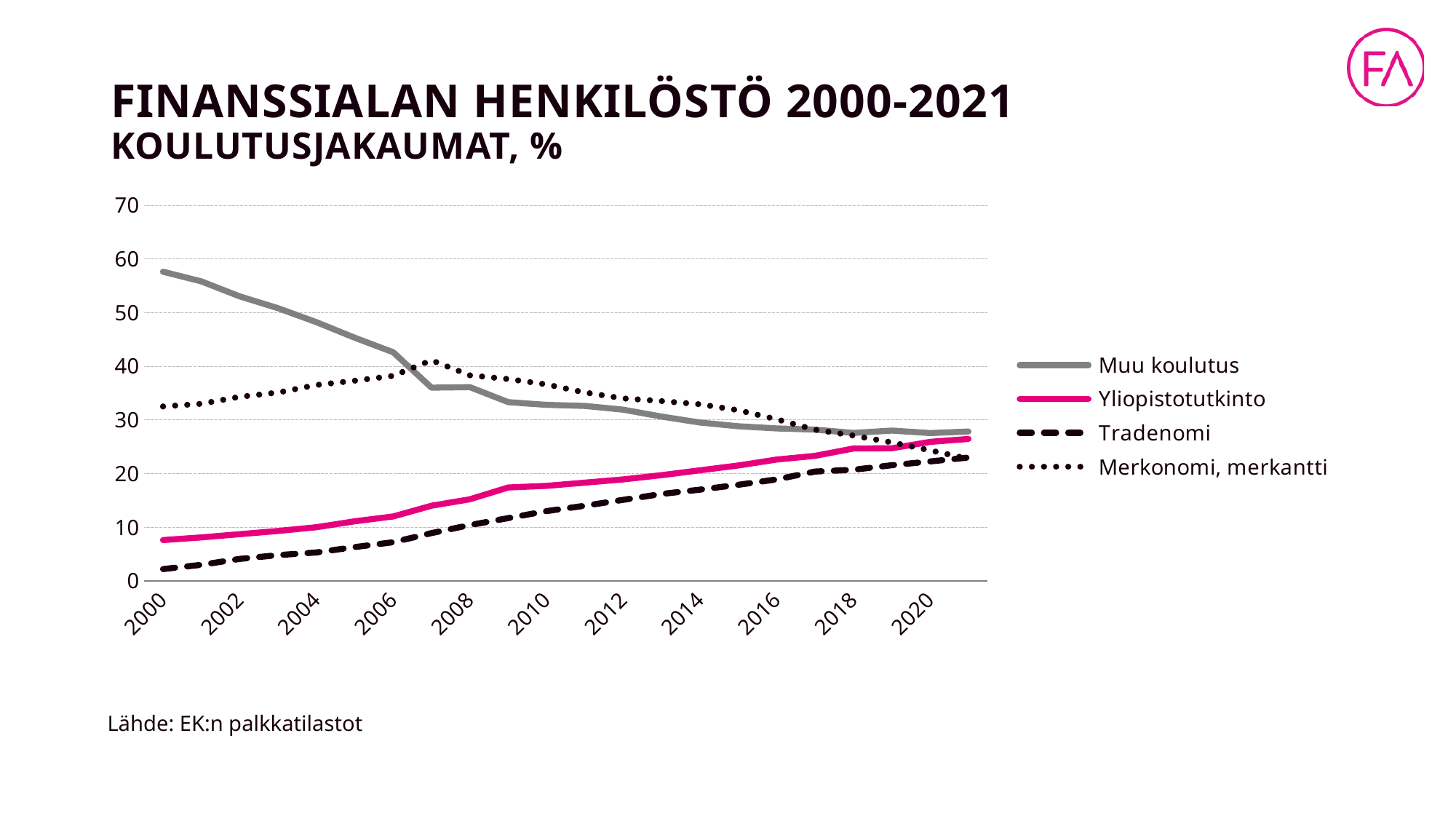
How many series does the legend list? 4 In 2010, which is larger: Muu koulutus or Yliopistotutkinto? Muu koulutus Is the value for Muu koulutus in 2020 greater or less than 30? less Which series has the lowest value in 2000? Tradenomi What kind of chart is shown on the slide? line chart Which series has the highest value in 2000? Muu koulutus Is the value for Merkonomi, merkantti in 2000 greater or less than 30? greater Is the value for Tradenomi in 2000 greater or less than 10? less Does the Muu koulutus series rise or fall from 2000 to 2021? fall What is the main title of the chart on the slide? FINANSSIALAN HENKILÖSTÖ 2000-2021 Does the Yliopistotutkinto series rise or fall from 2000 to 2021? rise